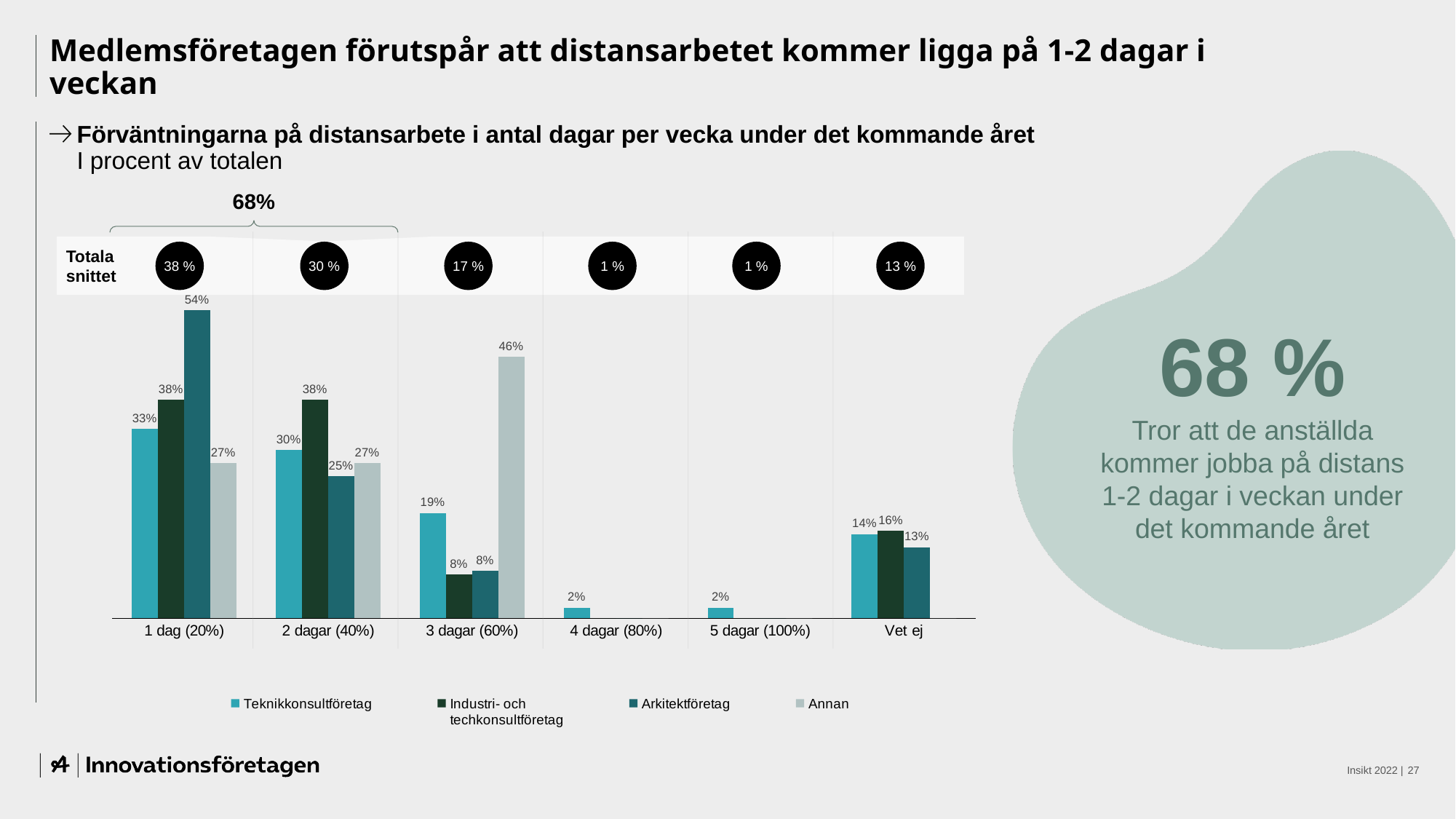
What kind of chart is shown on the slide? Bar chart What is the 'Totala snittet' value shown for 3 dagar (60%)? 17 % How many categories are shown on the x axis? 6 How many series does the legend list? 4 What is the value for Industri- och techkonsultföretag in the Vet ej category? 16% Which is larger in the 2 dagar (40%) category: Industri- och techkonsultföretag or Arkitektföretag? Industri- och techkonsultföretag Which category has the lowest value for Teknikkonsultföretag? 4 dagar (80%) and 5 dagar (100%) What is the value for Annan in the 3 dagar (60%) category? 46% What is the difference between Annan and Teknikkonsultföretag in the 3 dagar (60%) category? 27% What is the value for Arkitektföretag in the 1 dag (20%) category? 54% Which series has the highest value in the 1 dag (20%) category? Arkitektföretag What is the value for Teknikkonsultföretag in the 2 dagar (40%) category? 30%